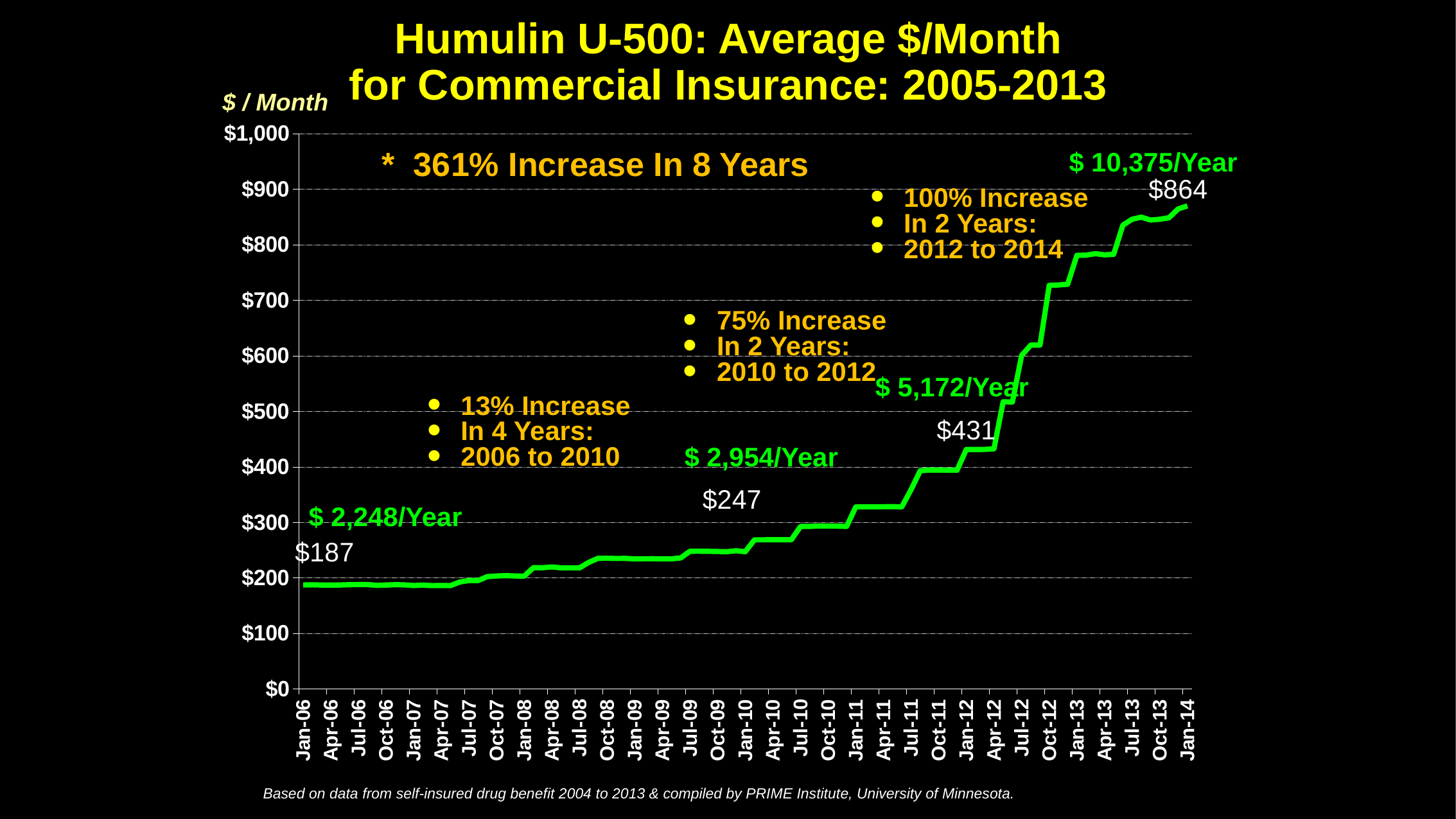
Is the value for Jan-11 greater or less than $400? less What is the difference between the labeled value around Jan-12 ($431) and the labeled value around Jan-10 ($247)? $184 What is the average $/month value labeled on the line around Jan-12? $431 What is the average $/month value labeled at the start of the line (Jan-06)? $187 What kind of chart is shown on the slide? line chart What is the average $/month value labeled on the line around Jan-10? $247 What is the difference between the labeled value at Jan-14 ($864) and the labeled value at Jan-06 ($187)? $677 Which of the labeled points is larger: Jan-12 or Jan-10? Jan-12 What annual cost is labeled in green next to the end of the line at Jan-14? $ 10,375/Year What is the average $/month value labeled at the end of the line (Jan-14)? $864 Do the values generally rise or fall from Jan-06 to Jan-14? rise Is the value for Jul-13 greater or less than $800? greater